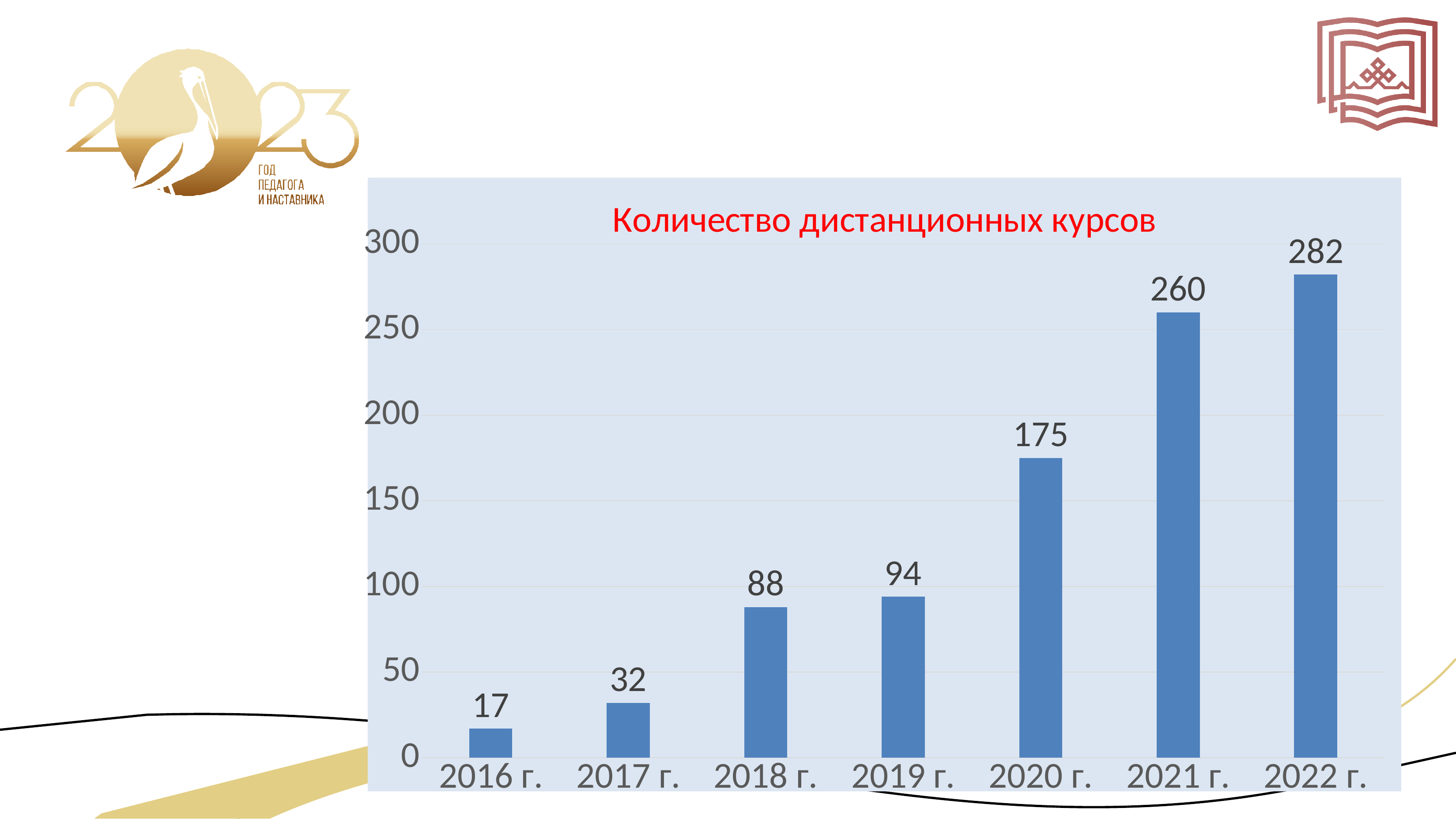
What is the value for 2017 г.? 32 What kind of chart is shown on the slide? bar chart What is the value for 2020 г.? 175 What is the difference between the values for 2020 г. and 2019 г.? 81 How many years are shown on the x axis? 7 Which year has the highest value? 2022 г. Which is larger, the value for 2018 г. or the value for 2019 г.? 2019 г. Is the value for 2021 г. greater or less than 250? greater What is the title of the chart? Количество дистанционных курсов Which year has the lowest value? 2016 г. What is the difference between the values for 2022 г. and 2021 г.? 22 Do the values rise or fall from 2016 г. to 2022 г.? rise